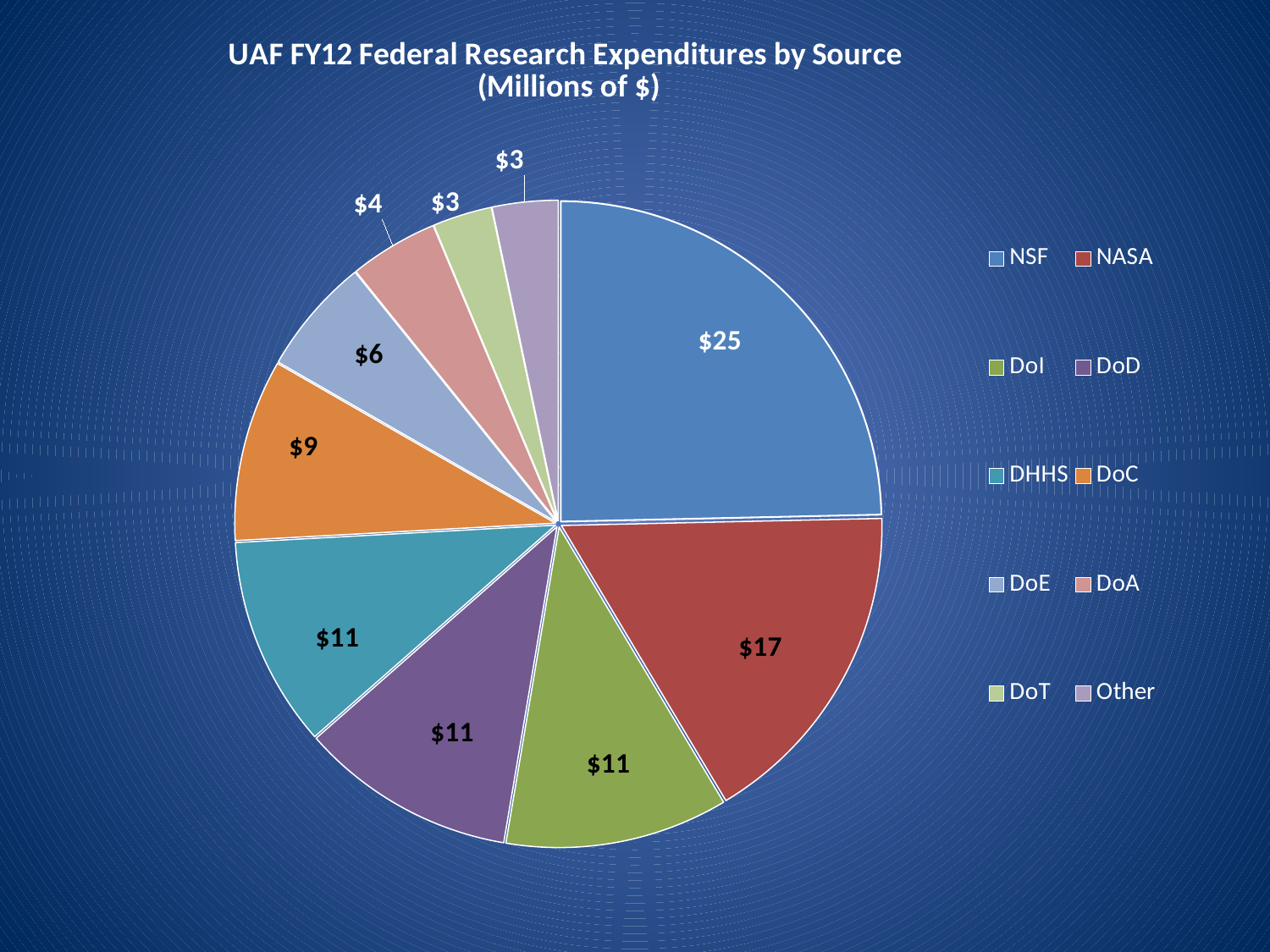
What is the value for NSF? $25 What is the difference between the NSF and NASA values? $8 Which source has the largest slice? NSF Which is larger, the value for DoC or the value for DoE? DoC What is the value for NASA? $17 What is the value for DoC? $9 What is the value for DoA? $4 What is the value for DoE? $6 What kind of chart is shown? Pie chart What is the title of the chart? UAF FY12 Federal Research Expenditures by Source (Millions of $) What share of the total does the NSF slice represent? 25% How many slices does the pie chart have? 10